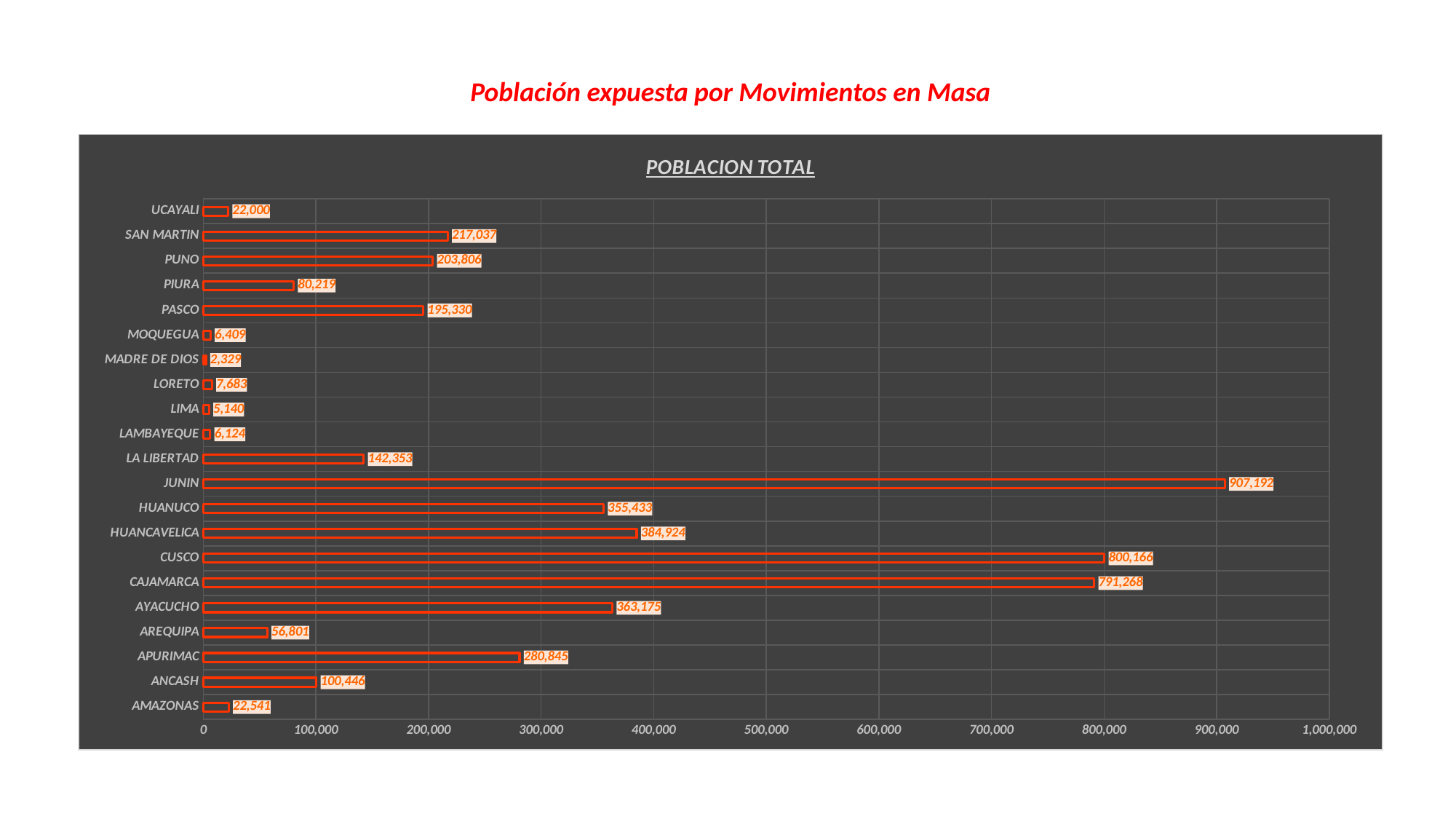
What is the difference between the values for CUSCO and CAJAMARCA? 8,898 What is the title of the chart? POBLACION TOTAL What is the value for JUNIN? 907,192 What is the value for MADRE DE DIOS? 2,329 What is the value for CAJAMARCA? 791,268 What kind of chart is shown? bar chart How many categories are shown in the chart? 21 What is the difference between the values for JUNIN and CUSCO? 107,026 Which category has the lowest value? MADRE DE DIOS Is the value for APURIMAC greater or less than 300,000? less Which is larger, the value for HUANCAVELICA or the value for HUANUCO? HUANCAVELICA Which category has the highest value? JUNIN